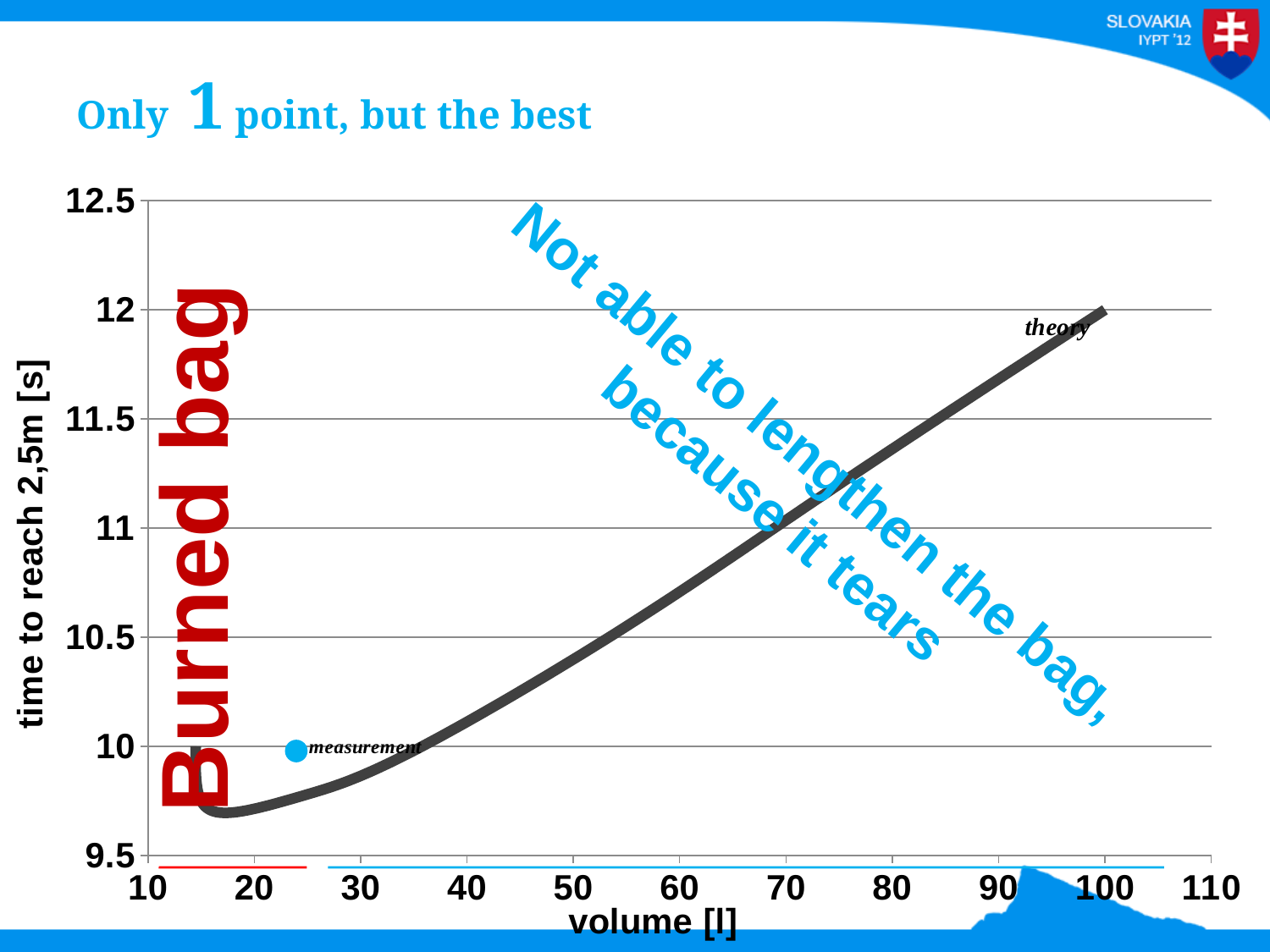
What kind of chart is shown on the slide? line chart Is the measurement point's time greater or less than 10.5 s? less How many measurement points are plotted on the chart? 1 What is the name of the curve plotted on the chart? theory Does the theory curve rise or fall as volume increases from 30 l to 100 l? rises Which is larger: the theory curve's value at 100 l or its value at 30 l? at 100 l What is the label of the y axis of the chart? time to reach 2,5m [s] Is the value of the theory curve at a volume of 60 l greater or less than 11 s? less What is the highest value shown on the y axis of the chart? 12.5 What is the label of the x axis of the chart? volume [l] Is the value of the theory curve at a volume of 90 l greater or less than 11.5 s? greater